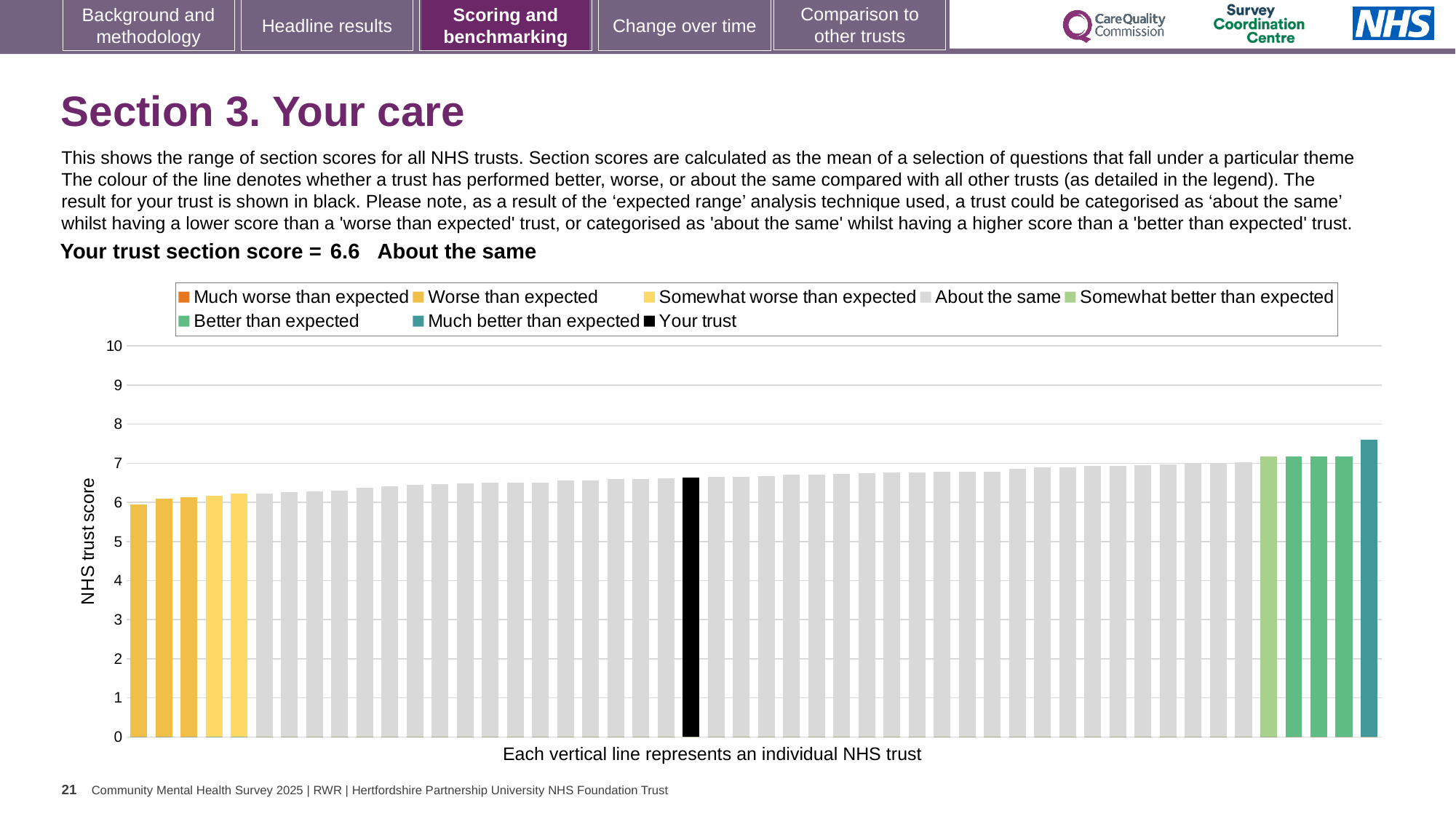
What is the label on the vertical axis? NHS trust score Do the bar values rise or fall from left to right along the x axis? rise Is the value of the tallest bar greater or less than 8? less How many bars are coloured as 'Much better than expected'? 1 What does each vertical line in the chart represent, according to the x-axis label? an individual NHS trust What is the section score for your trust? 6.6 Is the value of the tallest bar greater or less than 7? greater Is the value of the shortest bar greater or less than 5? greater How many entries does the legend list? 8 How many bars are coloured as 'Much worse than expected'? 0 What kind of chart is shown on the slide? bar chart Which category is your trust placed in for this section? About the same